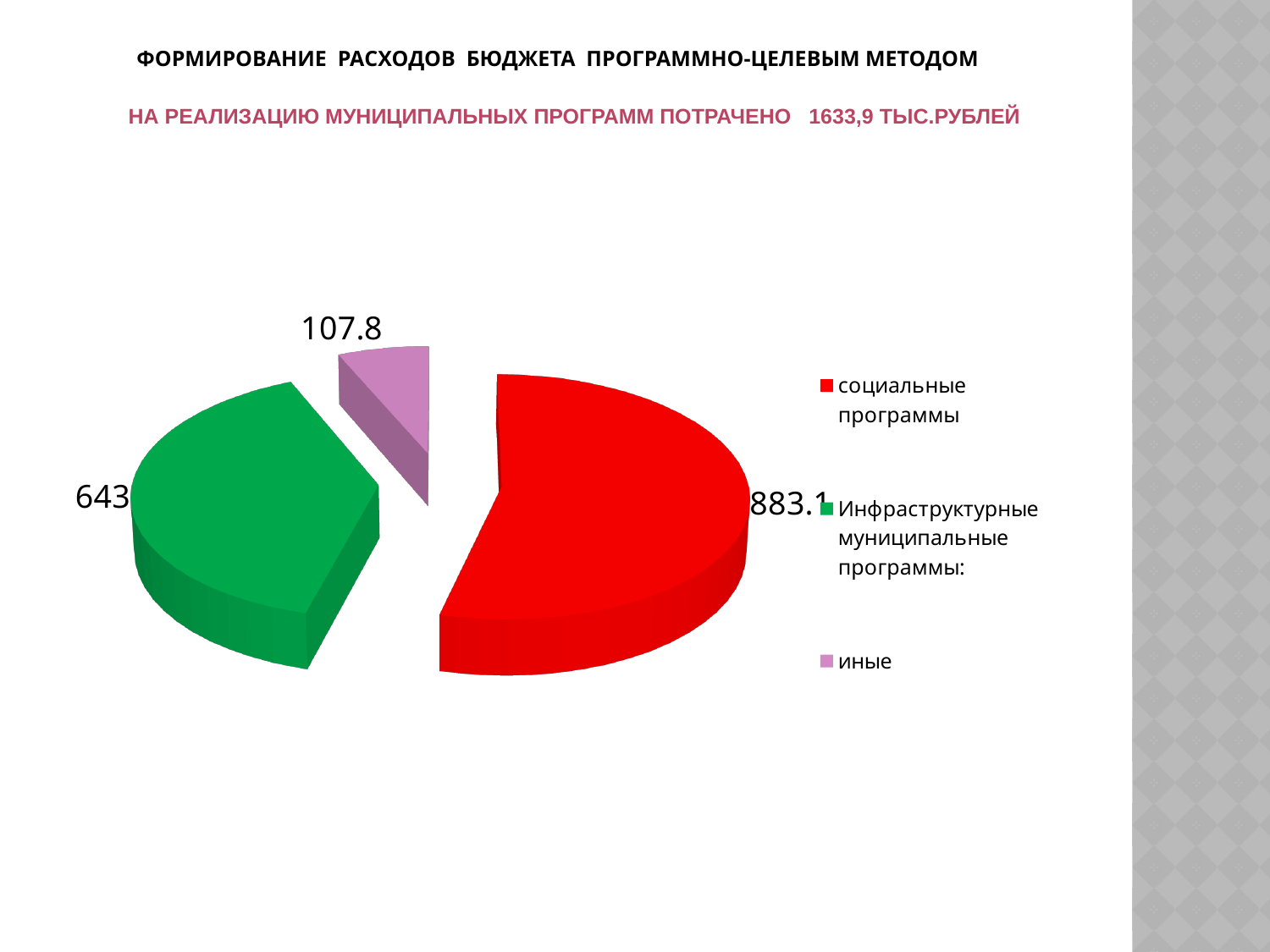
What is the value for Инфраструктурные муниципальные программы? 643 What is the difference between the values for социальные программы and Инфраструктурные муниципальные программы? 240.1 Which is larger: the value for Инфраструктурные муниципальные программы or the value for иные? Инфраструктурные муниципальные программы What is the difference between the values for Инфраструктурные муниципальные программы and иные? 535.2 Which category has the largest slice of the pie? социальные программы What is the total of all three slices in the pie chart? 1633.9 What type of chart is shown on the slide? pie chart What is the value for социальные программы? 883.1 How many slices does the pie chart have? 3 What is the value for иные? 107.8 Which category has the smallest slice of the pie? иные What colour is the slice for социальные программы? red